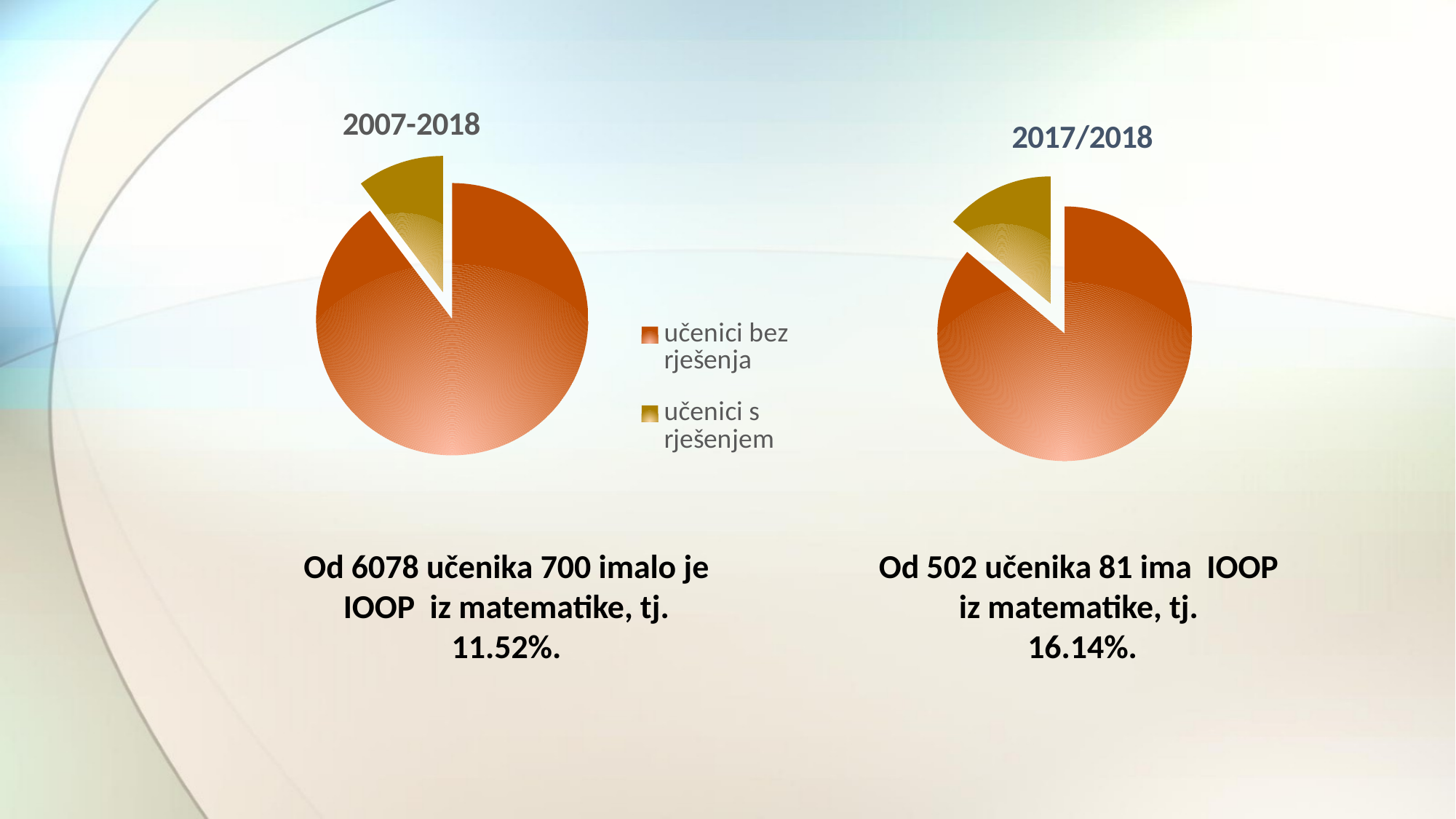
Is the slice for učenici s rješenjem larger in the 2007-2018 chart or in the 2017/2018 chart? 2017/2018 In the 2007-2018 pie chart, what share of students are učenici s rješenjem, according to the text below the chart? 11.52% According to the text under the 2007-2018 chart, how many of the 6078 students had IOOP in mathematics? 700 According to the text under the 2017/2018 chart, how many of the 502 students have IOOP in mathematics? 81 How many slices does the 2017/2018 pie chart have? 2 In the 2007-2018 pie chart, which category has the largest slice? učenici bez rješenja What is the title of the pie chart on the left? 2007-2018 What colour represents učenici s rješenjem in the pie charts? gold In the 2017/2018 pie chart, which category has the smallest slice? učenici s rješenjem How many entries does the legend list for the pie charts? 2 In the 2017/2018 pie chart, what share of students are učenici s rješenjem, according to the text below the chart? 16.14% What kind of chart is the 2007-2018 chart? pie chart